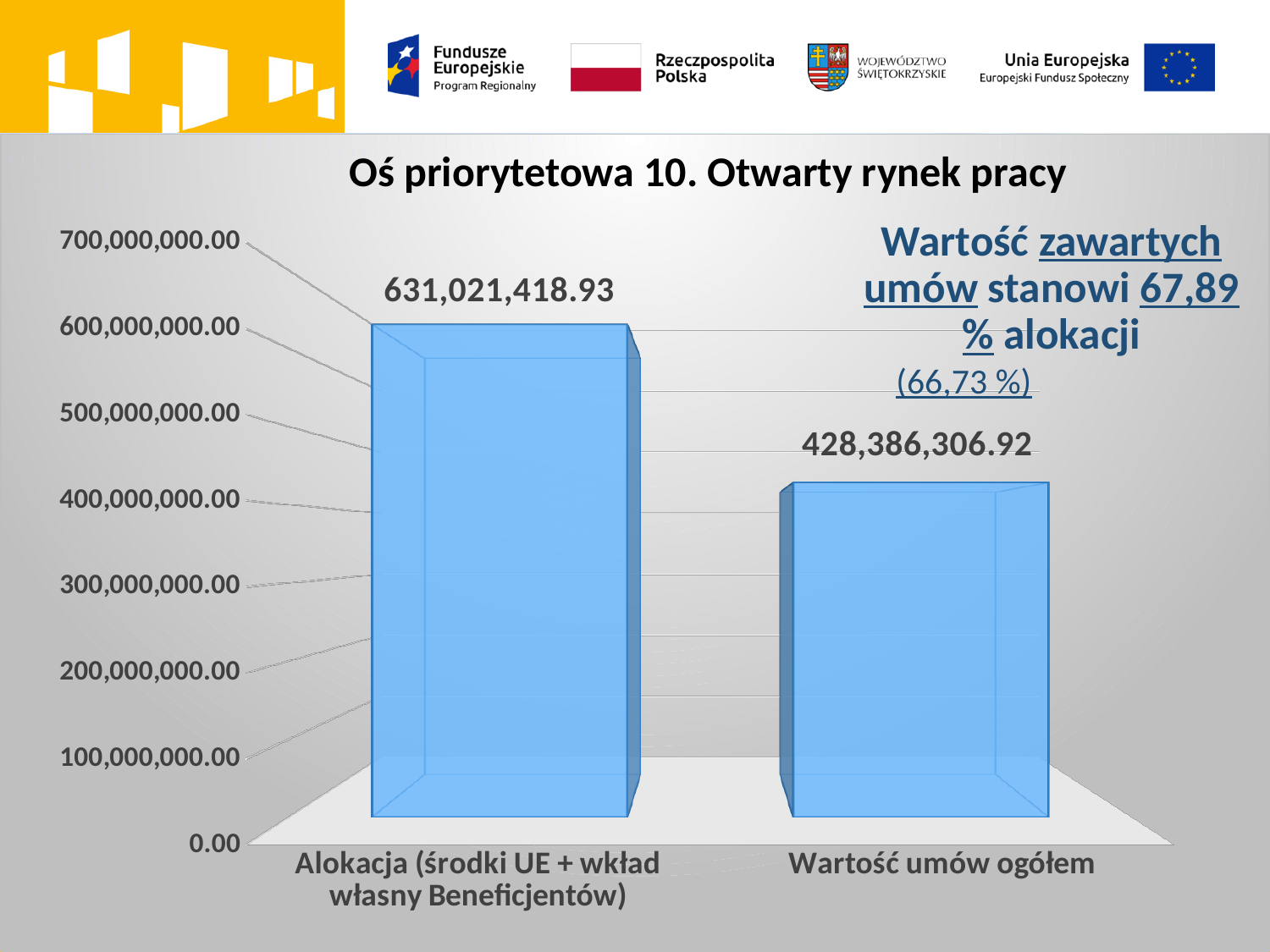
Which is larger: the value for "Alokacja (środki UE + wkład własny Beneficjentów)" or the value for "Wartość umów ogółem"? Alokacja (środki UE + wkład własny Beneficjentów) How many categories are shown on the chart? 2 What is the difference between the value for "Alokacja (środki UE + wkład własny Beneficjentów)" and the value for "Wartość umów ogółem"? 202,635,112.01 Is the value for "Wartość umów ogółem" greater or less than 500,000,000.00? less What kind of chart is shown on the slide? bar chart According to the text on the slide, what percentage of the allocation does the value of concluded contracts represent? 67,89 % Which category has the lowest value? Wartość umów ogółem What is the title of the slide above the chart? Oś priorytetowa 10. Otwarty rynek pracy What is the value for "Wartość umów ogółem"? 428,386,306.92 Which category has the highest value? Alokacja (środki UE + wkład własny Beneficjentów) Is the value for "Alokacja (środki UE + wkład własny Beneficjentów)" greater or less than 600,000,000.00? greater What is the value for "Alokacja (środki UE + wkład własny Beneficjentów)"? 631,021,418.93